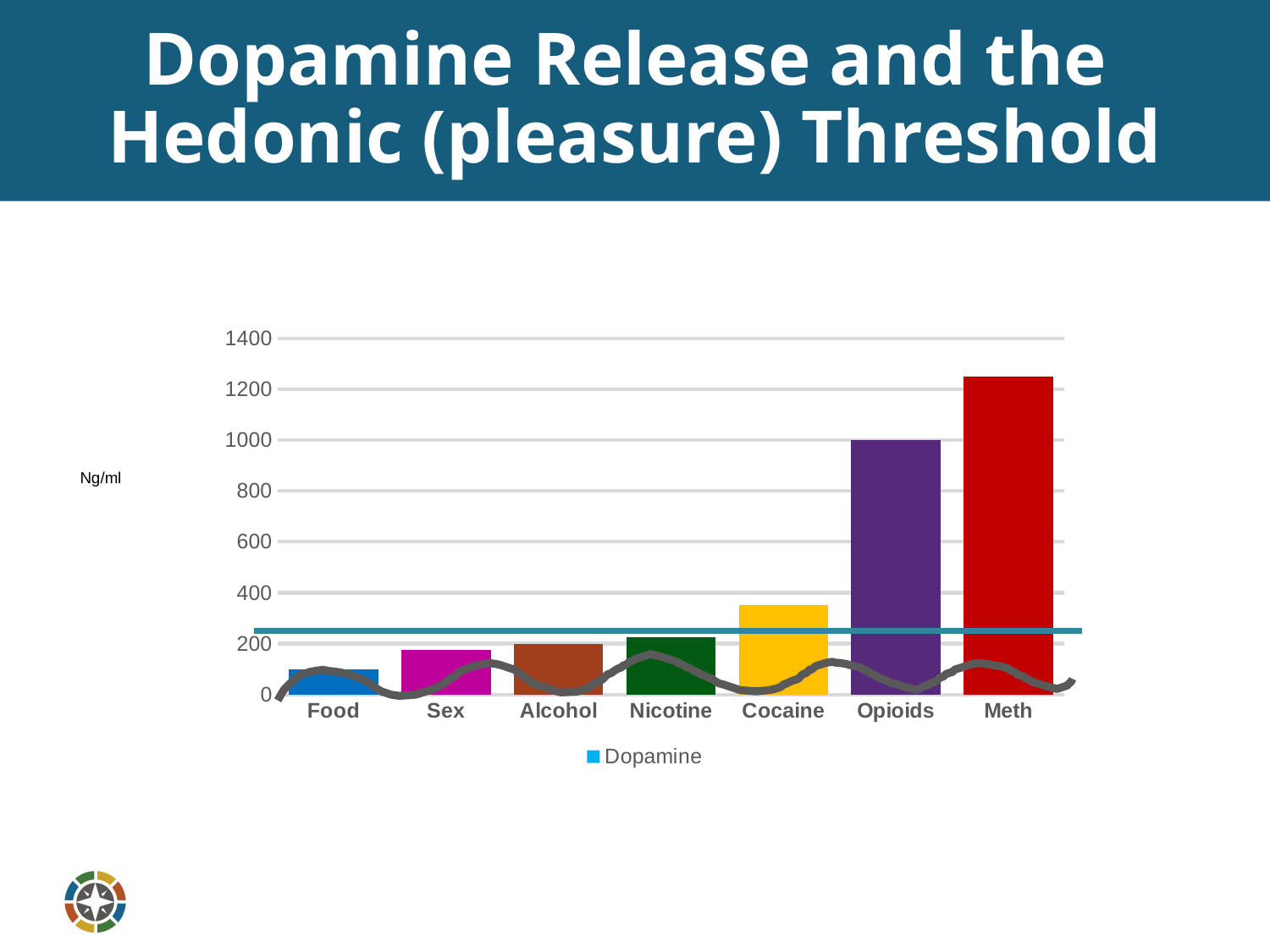
How many categories are shown on the x axis of the chart? 7 Is the value for Food greater or less than 200? less Which category has the highest dopamine value? Meth What unit label is shown next to the chart's vertical axis? Ng/ml How many series does the chart's legend list? 1 Which is larger, the value for Opioids or the value for Cocaine? Opioids What is the title of the slide containing the chart? Dopamine Release and the Hedonic (pleasure) Threshold What kind of chart is shown on the slide? bar chart Do the values rise or fall moving from Food to Meth along the x axis? rise Is the value for Meth greater or less than 1200? greater Which category has the lowest dopamine value? Food Is the value for Cocaine greater or less than 400? less